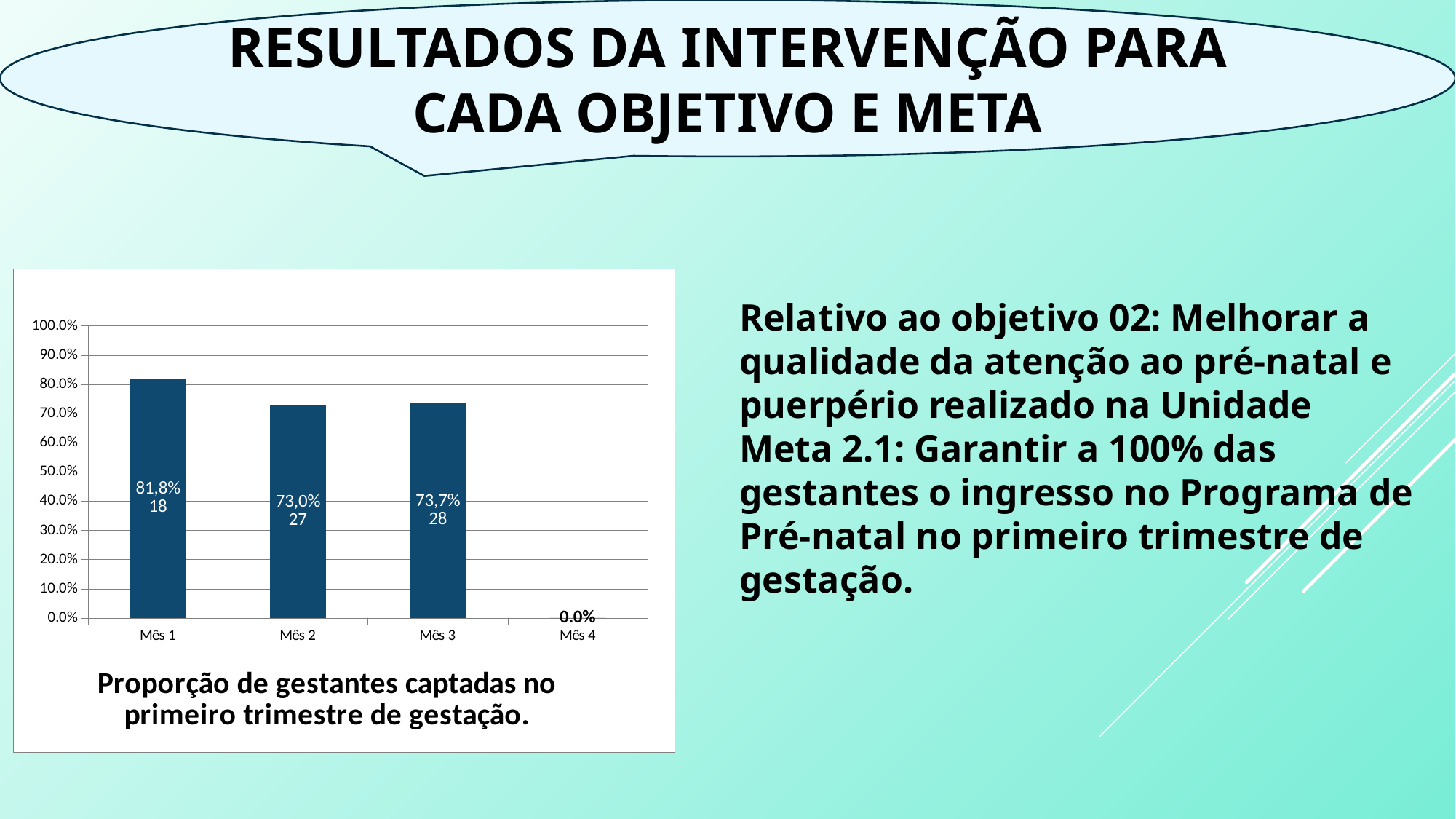
What is the title of the chart? Proporção de gestantes captadas no primeiro trimestre de gestação. Which is larger, the value for Mês 1 or the value for Mês 2? Mês 1 Which month has the lowest value in the chart? Mês 4 Which month has the highest proportion of gestantes captadas no primeiro trimestre? Mês 1 What is the difference in percentage points between Mês 1 and Mês 2? 8,8 percentage points What type of chart is shown on the slide? Bar chart What is the percentage value shown for Mês 3? 73,7% What count is printed on the bar for Mês 3? 28 How many months (categories) are shown on the x axis? 4 What is the percentage value shown for Mês 2? 73,0% What is the value shown for Mês 4? 0.0% What is the percentage value shown for Mês 1? 81,8%